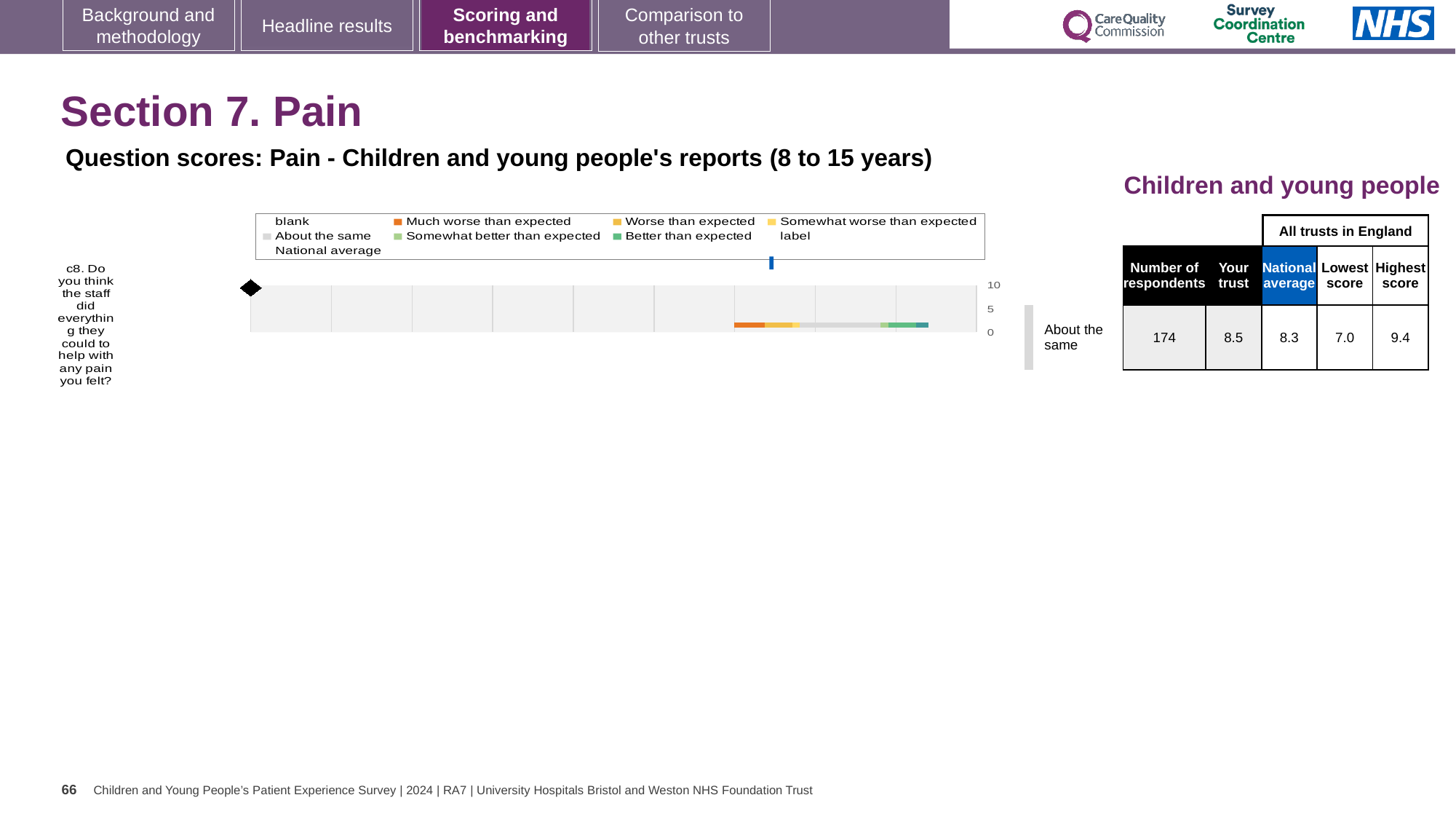
What is the difference between the highest and lowest scores among all trusts for question c8? 2.4 What is the highest score among all trusts in England for question c8? 9.4 Which benchmark category is the trust's result for c8 placed in? About the same How many survey questions are plotted on the chart? 1 What kind of chart is used to show the question score for c8? bar chart What is the national average score for question c8? 8.3 Is the trust's score for question c8 greater or less than 5 on the chart's axis? greater What is the trust's score for question c8, as shown in the table beside the chart? 8.5 What is the difference between the trust's score and the national average for question c8? 0.2 Which is larger for question c8: the trust's score or the national average? the trust's score What is the lowest score among all trusts in England for question c8? 7.0 How many respondents answered question c8? 174